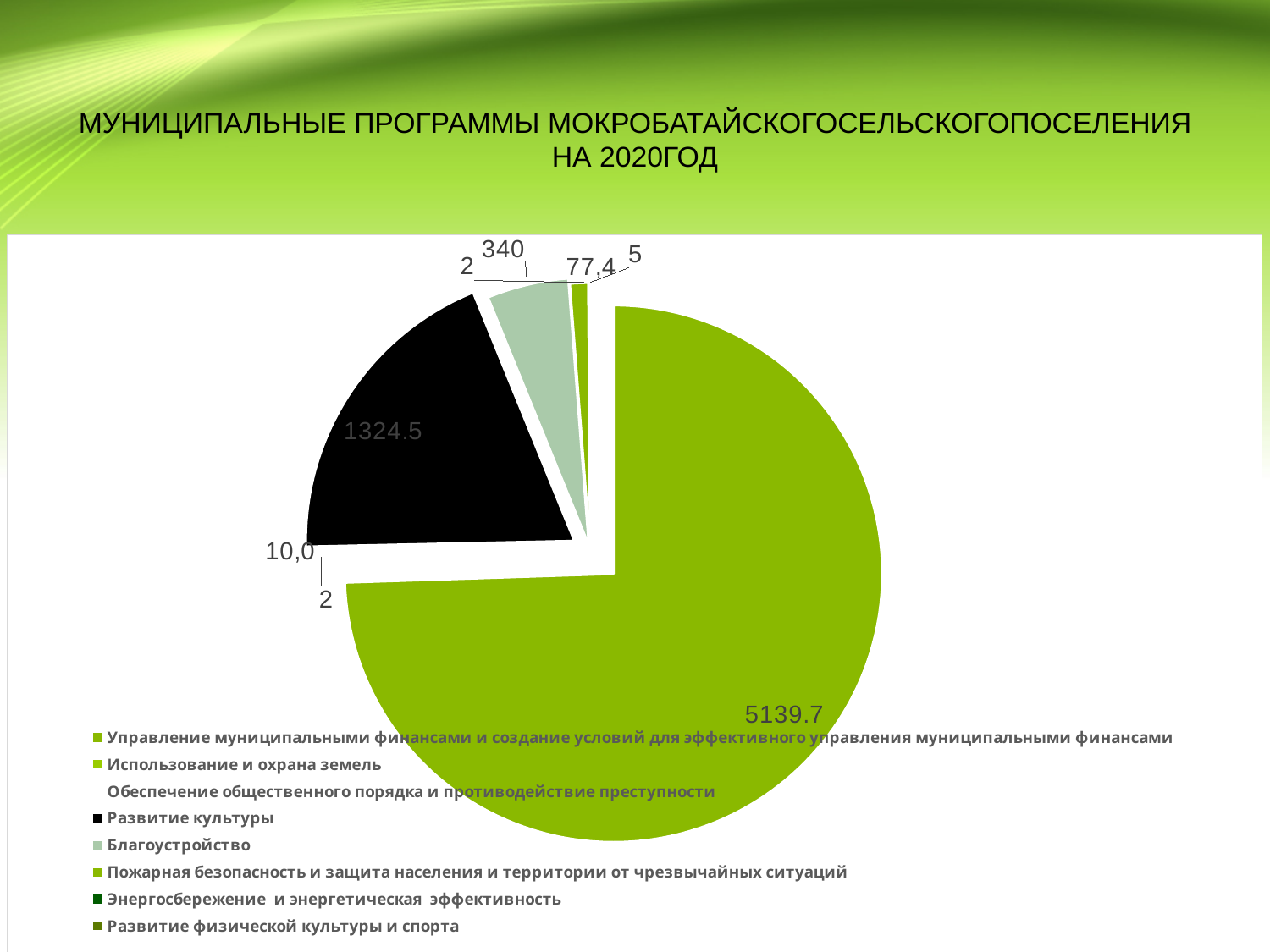
What is the value of the largest slice of the pie chart? 5139.7 What is the difference between the largest slice (5139.7) and the Развитие культуры slice (1324.5)? 3815.2 What year does the slide title say the municipal programmes are for? 2020 What colour is the slice for Развитие культуры? Black What is the value shown for the black slice (Развитие культуры)? 1324.5 Which programme has the largest slice in the pie chart? Управление муниципальными финансами и создание условий для эффективного управления муниципальными финансами What is the value shown for Пожарная безопасность и защита населения и территории от чрезвычайных ситуаций? 77,4 What kind of chart is shown on the slide? Pie chart What is the difference between the Развитие культуры slice (1324.5) and the Благоустройство slice (340)? 984.5 What is the value shown for Благоустройство? 340 Which is larger: the slice for Развитие культуры or the slice for Благоустройство? Развитие культуры How many entries does the legend list? 8